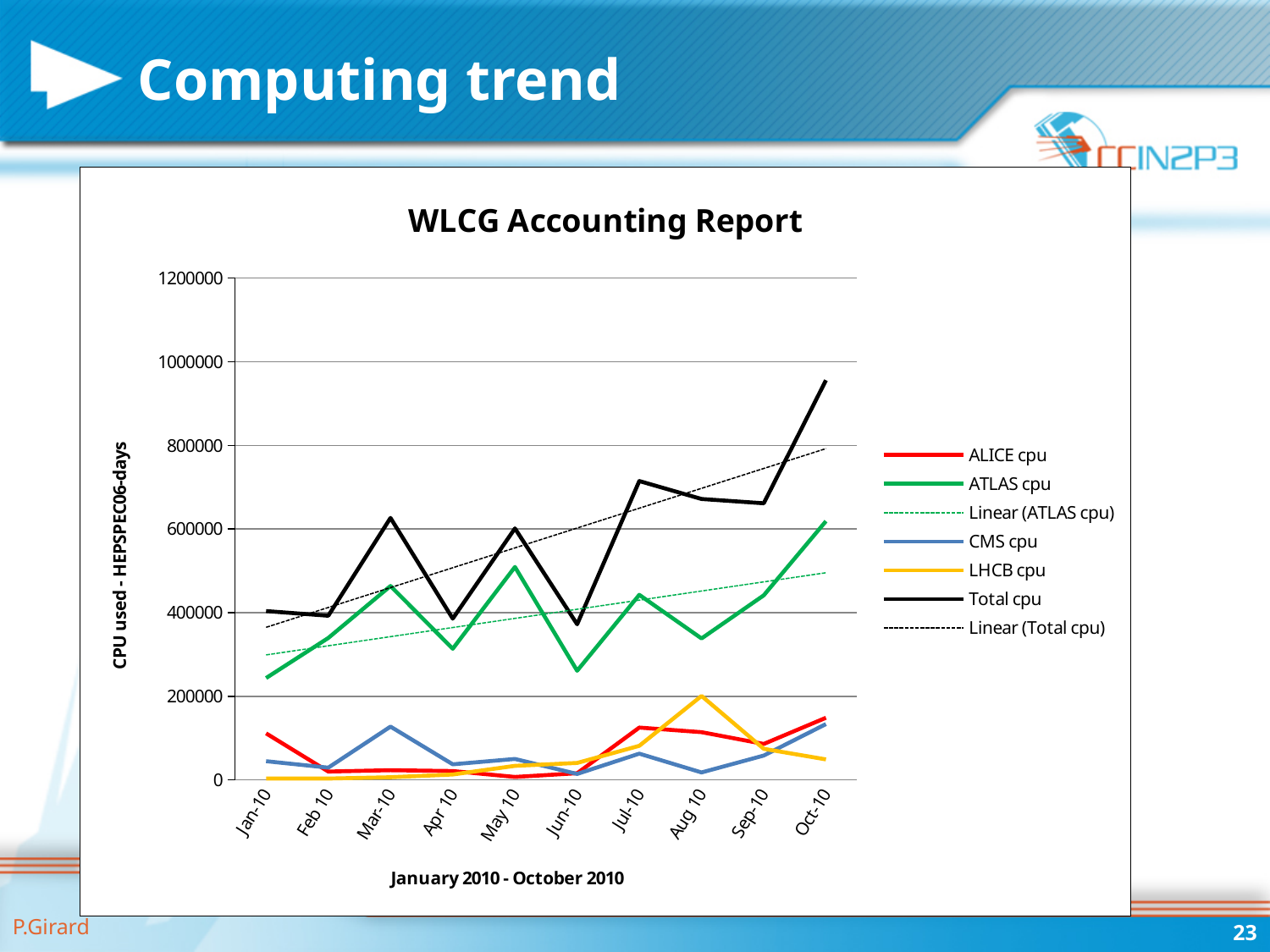
Does the Total cpu series generally rise or fall from Jan-10 to Oct-10? Rise Is the Total cpu value for Jul-10 greater or less than 600000? greater What is the label of the vertical axis? CPU used - HEPSPEC06-days Is the ATLAS cpu value for Jun-10 greater or less than 400000? less Which is larger, the Total cpu value for Jul-10 or for Apr-10? Jul-10 Is the Total cpu value for Oct-10 greater or less than 800000? greater How many months are plotted along the x axis? 10 How many series does the legend list? 7 What kind of chart is shown on the slide? Line chart What is the title of the chart? WLCG Accounting Report In which month is the ATLAS cpu value lowest? Jan-10 In which month is the Total cpu value highest? Oct-10